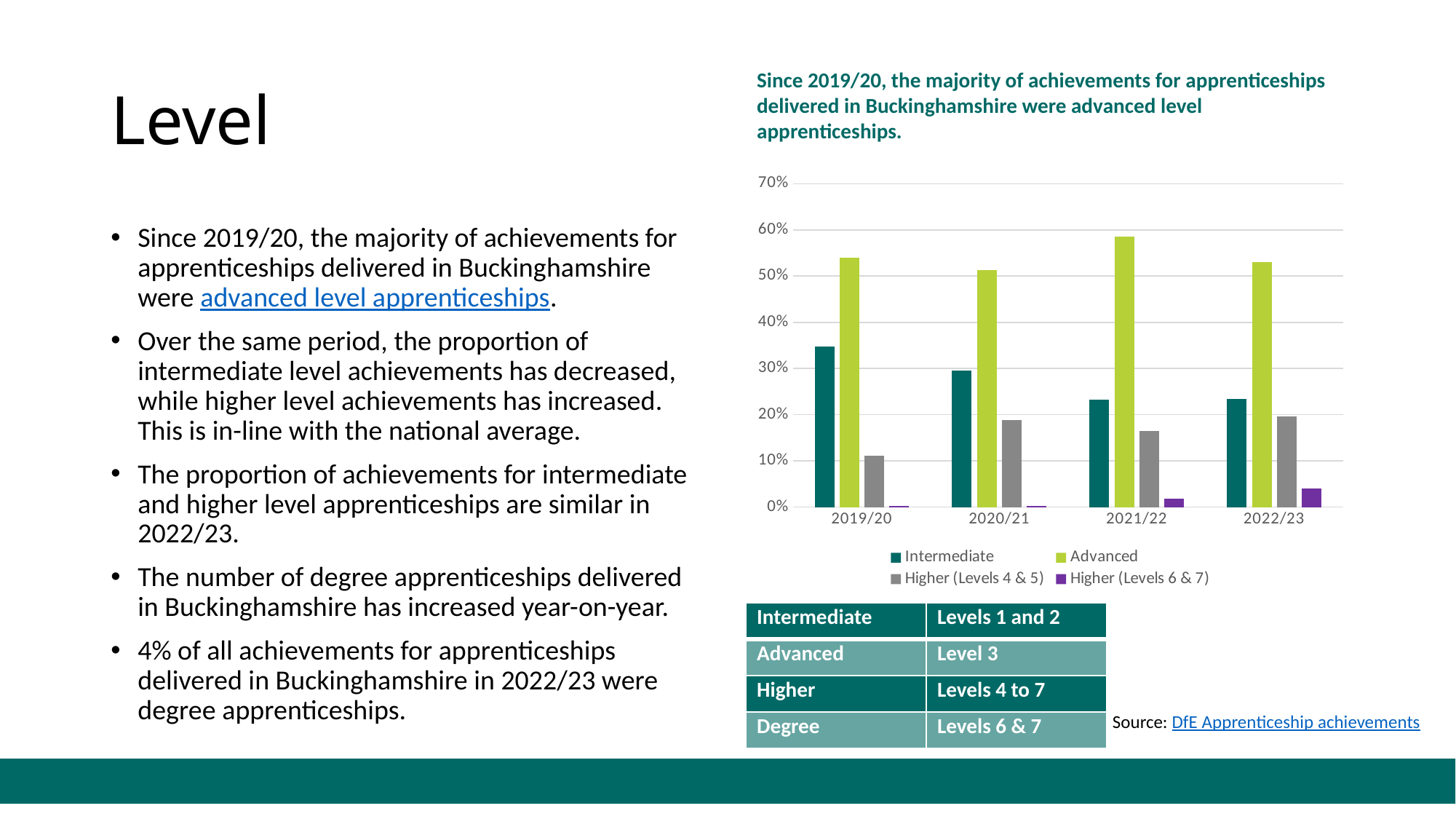
In which year is the Higher (Levels 4 & 5) bar the lowest? 2019/20 In which year is the Intermediate bar the highest? 2019/20 Does the Higher (Levels 6 & 7) series rise or fall from 2019/20 to 2022/23? Rise In which year is the Advanced bar the highest? 2021/22 How many series does the chart's legend list? 4 What kind of chart is shown on the slide? Bar chart How many academic years are shown on the x axis of the chart? 4 Is the Intermediate value for 2019/20 greater or less than 30%? greater Does the Intermediate series rise or fall from 2019/20 to 2022/23? Fall Is the Advanced value for 2021/22 greater or less than 60%? less In 2020/21, which is larger: the Intermediate bar or the Higher (Levels 4 & 5) bar? Intermediate Is the Higher (Levels 4 & 5) value for 2019/20 greater or less than 20%? less